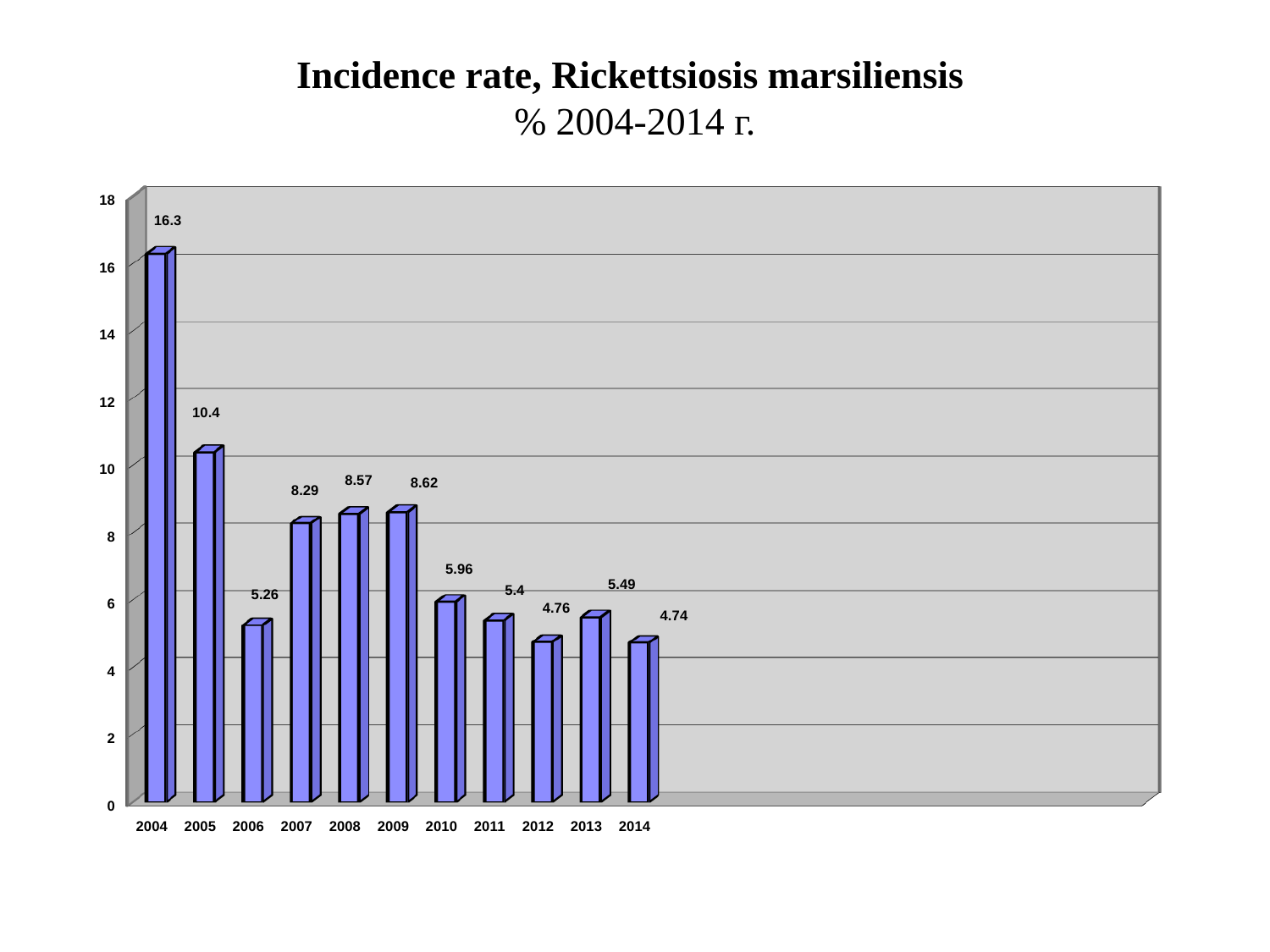
What is the incidence rate for 2012? 4.76 Does the incidence rate rise or fall from 2004 to 2006? fall Which year has the lowest incidence rate? 2014 Is the value for 2007 greater or less than 8? greater How many years are shown on the x axis? 11 What is the incidence rate for 2009? 8.62 What is the difference between the incidence rates for 2010 and 2011? 0.56 What is the incidence rate for 2004? 16.3 Which year has the highest incidence rate? 2004 What kind of chart is shown on the slide? bar chart What is the difference between the incidence rates for 2004 and 2005? 5.9 Which year has a higher incidence rate, 2006 or 2013? 2013